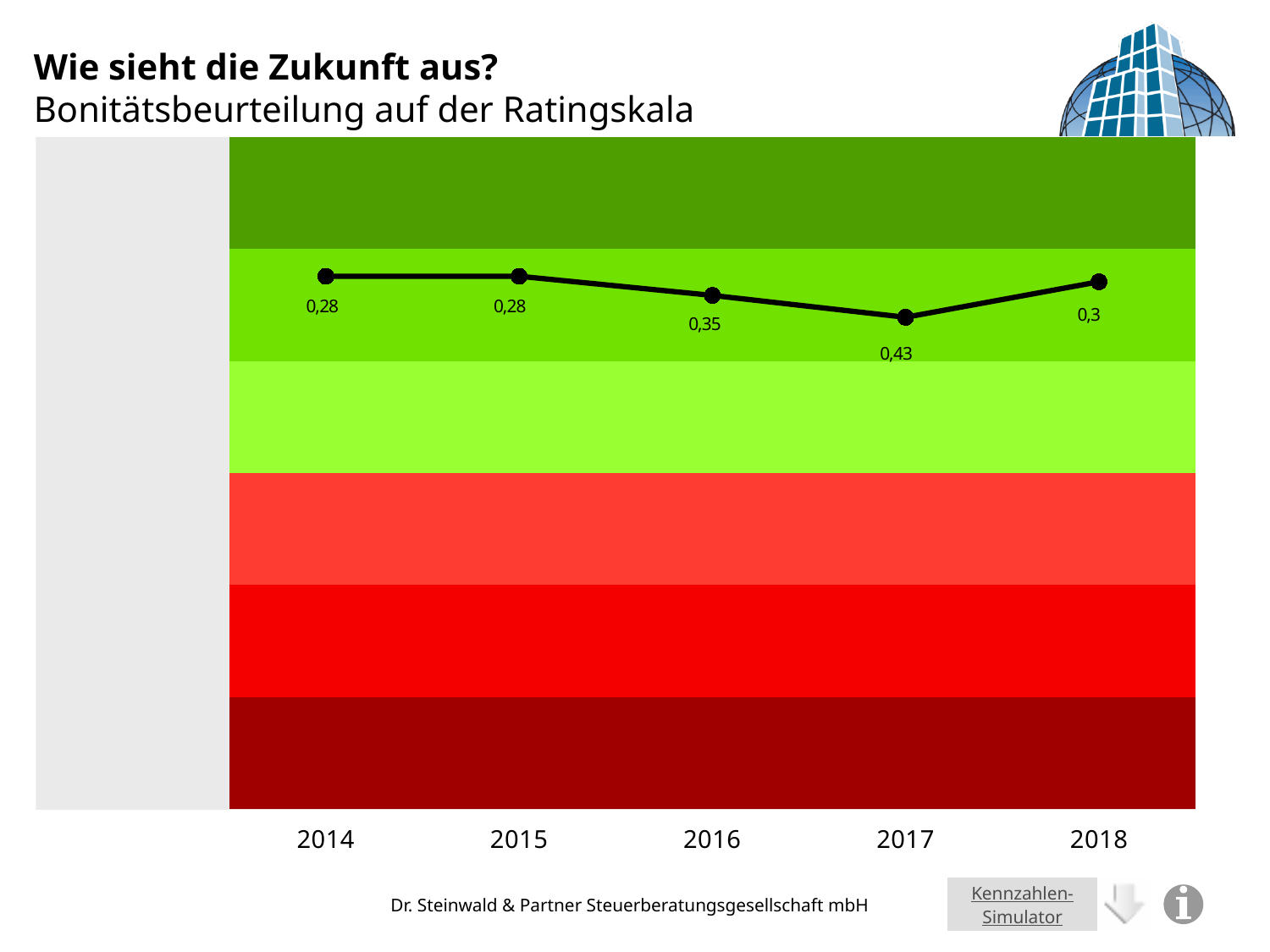
What is the difference between the values for 2017 and 2016? 0,08 What is the subtitle of the chart shown on the slide? Bonitätsbeurteilung auf der Ratingskala What is the value plotted for 2018? 0,3 What is the value plotted for 2014? 0,28 Which year has the highest plotted value? 2017 How many years are plotted on the x axis? 5 Which year has the larger value, 2016 or 2018? 2016 What kind of chart is shown on the slide? line chart What is the difference between the values for 2017 and 2018? 0,13 What is the value plotted for 2017? 0,43 What is the value plotted for 2016? 0,35